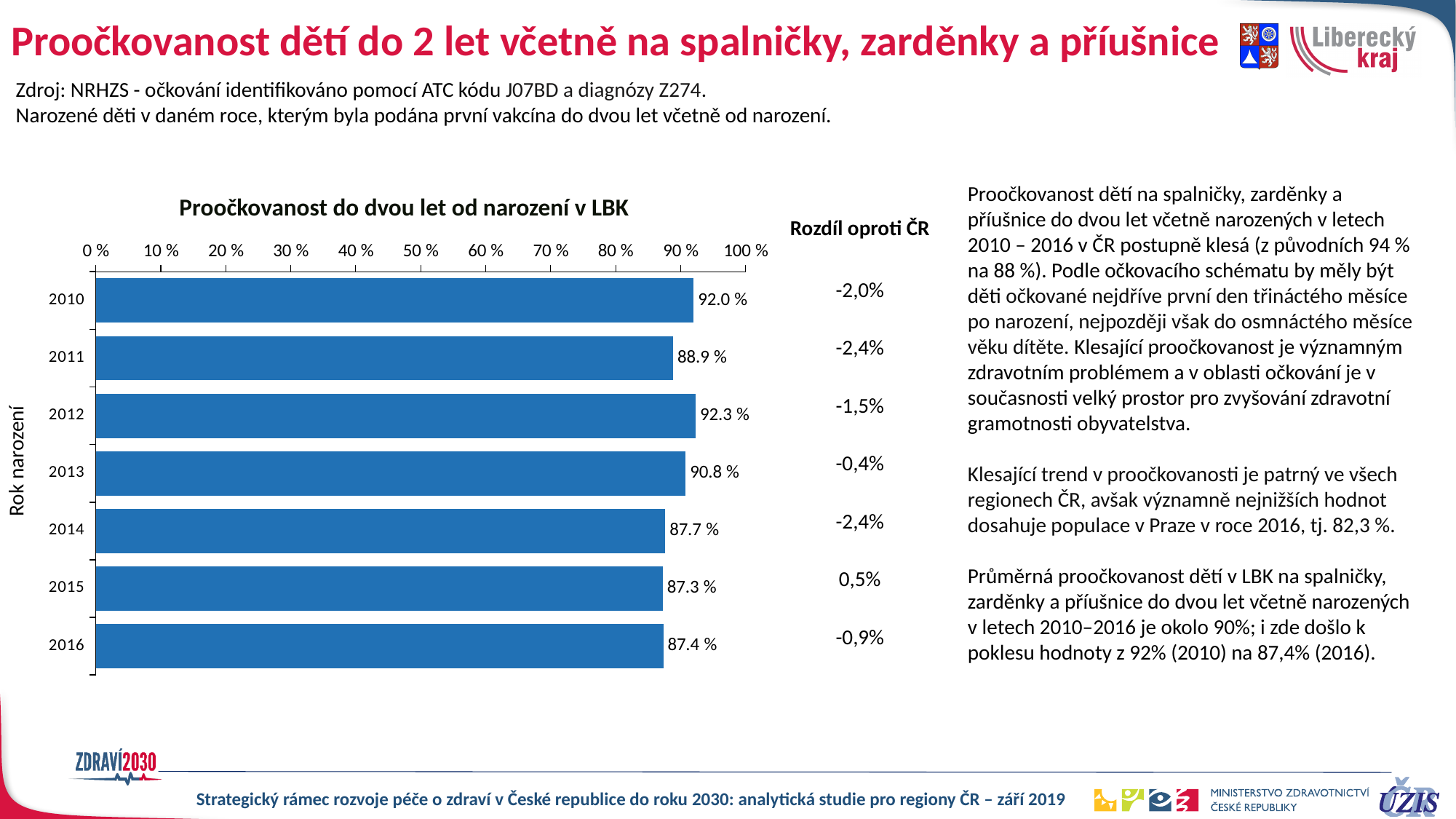
What is the 'Rozdíl oproti ČR' value listed for 2015? 0,5% Do the values generally rise or fall from 2010 to 2016? Fall What is the label of the vertical axis of the chart? Rok narození What type of chart is shown on the slide? Bar chart What is the value shown for 2013? 90.8 % Which year has the lowest vaccination coverage in the chart? 2015 What is the difference between the 2010 and 2016 values? 4.6 % Which year has the highest vaccination coverage in the chart? 2012 Which year has a higher value, 2011 or 2014? 2011 What is the vaccination coverage value for 2010 in the chart 'Proočkovanost do dvou let od narození v LBK'? 92.0 % What is the vaccination coverage value for 2016? 87.4 % How many years (bars) are shown in the chart? 7